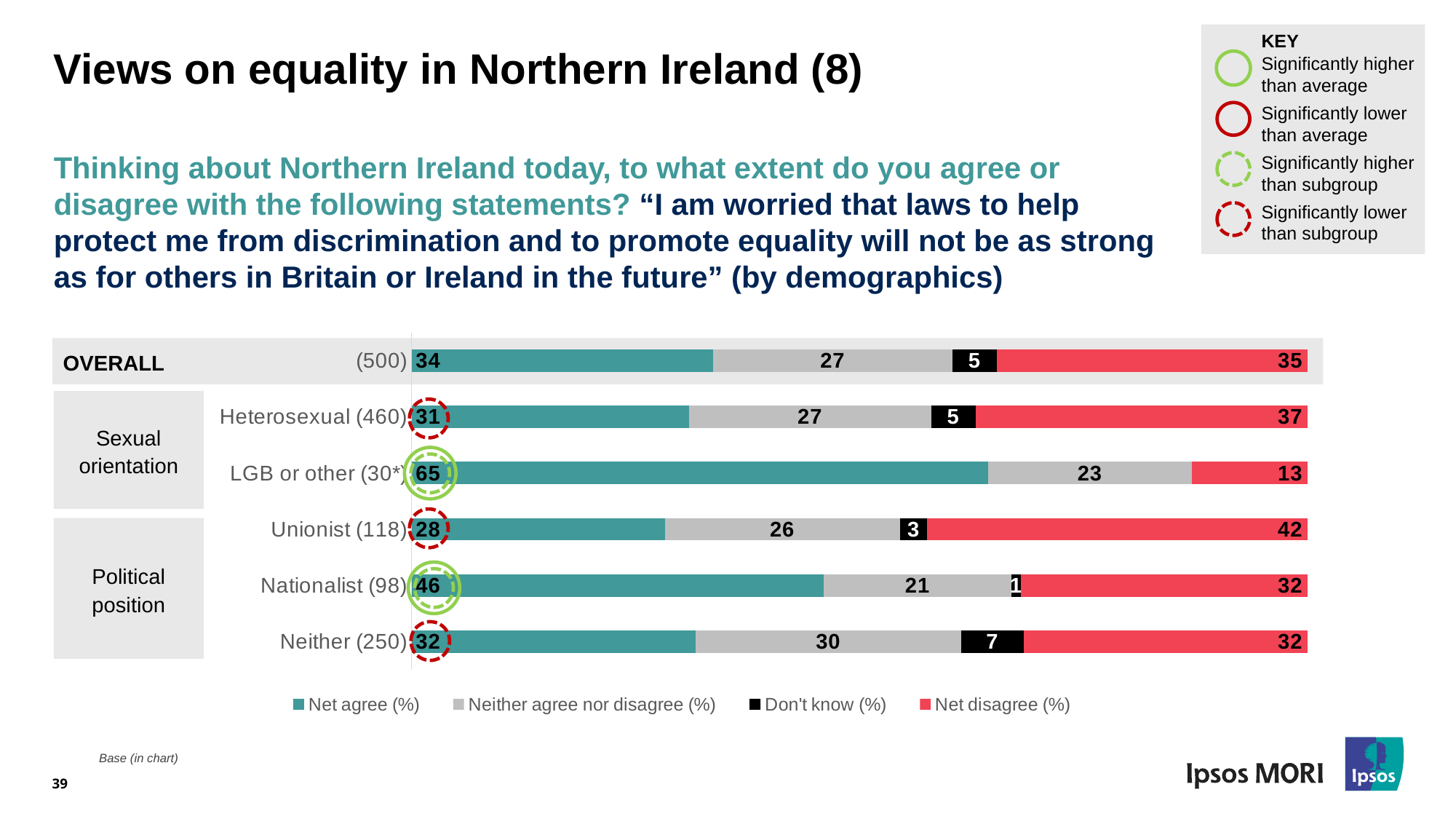
How many series does the legend list? 4 Which colour represents Net disagree (%) in the chart? Red What is the difference between the Net disagree (%) values for Unionist and Nationalist? 10 Which is larger, the Net agree (%) value for Heterosexual or for Nationalist? Nationalist What is the Net agree (%) value for LGB or other? 65 What is the Don't know (%) value for Nationalist? 1 Which group has the lowest Net disagree (%) value? LGB or other What is the Neither agree nor disagree (%) value for Neither (political position)? 30 What kind of chart is shown on the slide? Stacked bar chart Which group has the highest Net agree (%) value? LGB or other How many groups (bars) are shown in the chart? 6 What is the Net disagree (%) value for Unionist? 42